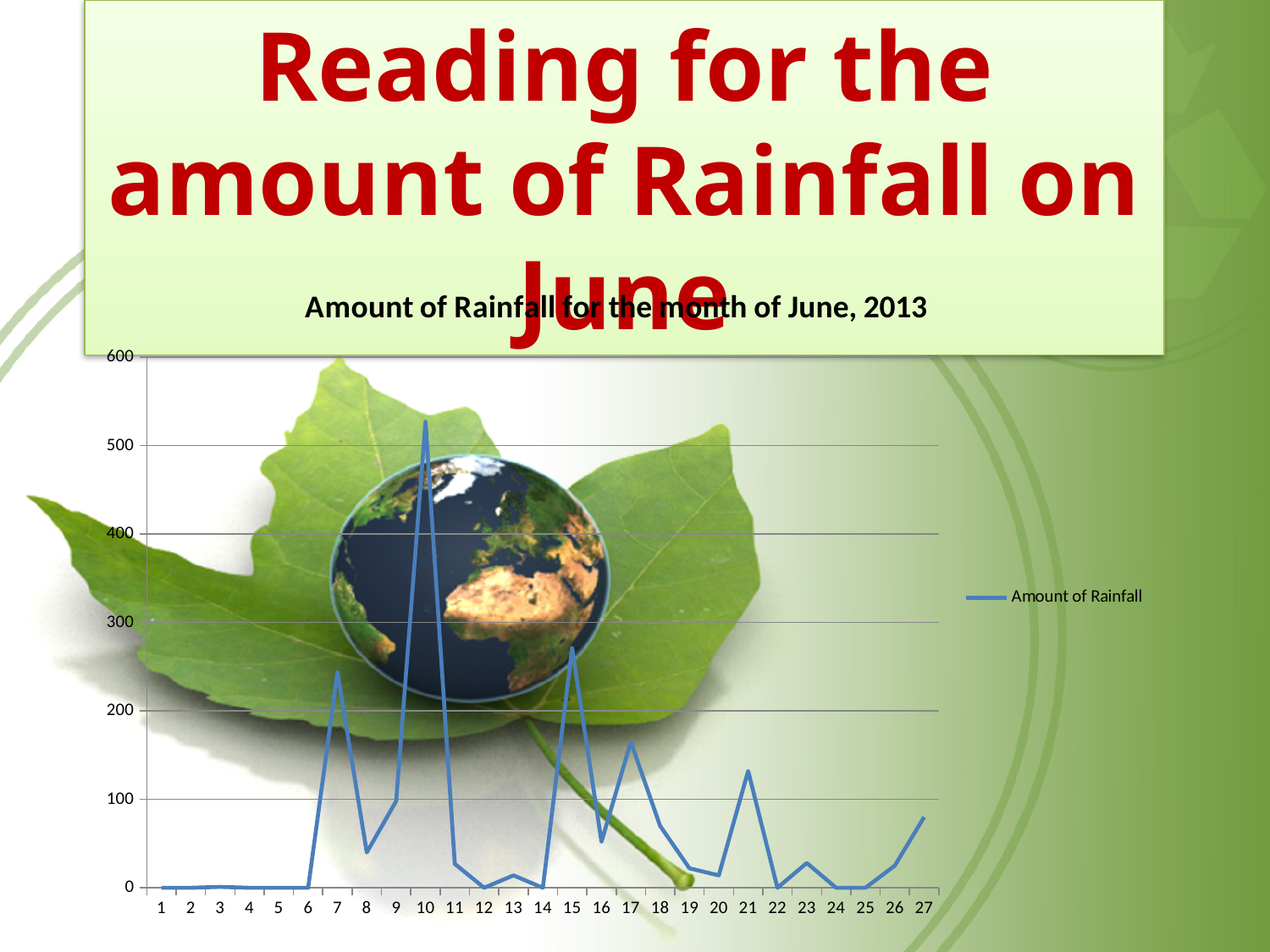
Is the value for day 7 greater or less than 200? greater Is the value for day 15 greater or less than 300? less Is the value for day 10 greater or less than 500? greater Which day has the larger amount of rainfall, day 10 or day 15? 10 Which day has the larger amount of rainfall, day 17 or day 21? 17 From day 24 to day 27, does the amount of rainfall rise or fall? rise What is the title of the chart? Amount of Rainfall for the month of June, 2013 How many series does the legend list? 1 What kind of chart is shown on the slide? line chart On which day is the amount of rainfall highest? 10 How many days are plotted along the x axis? 27